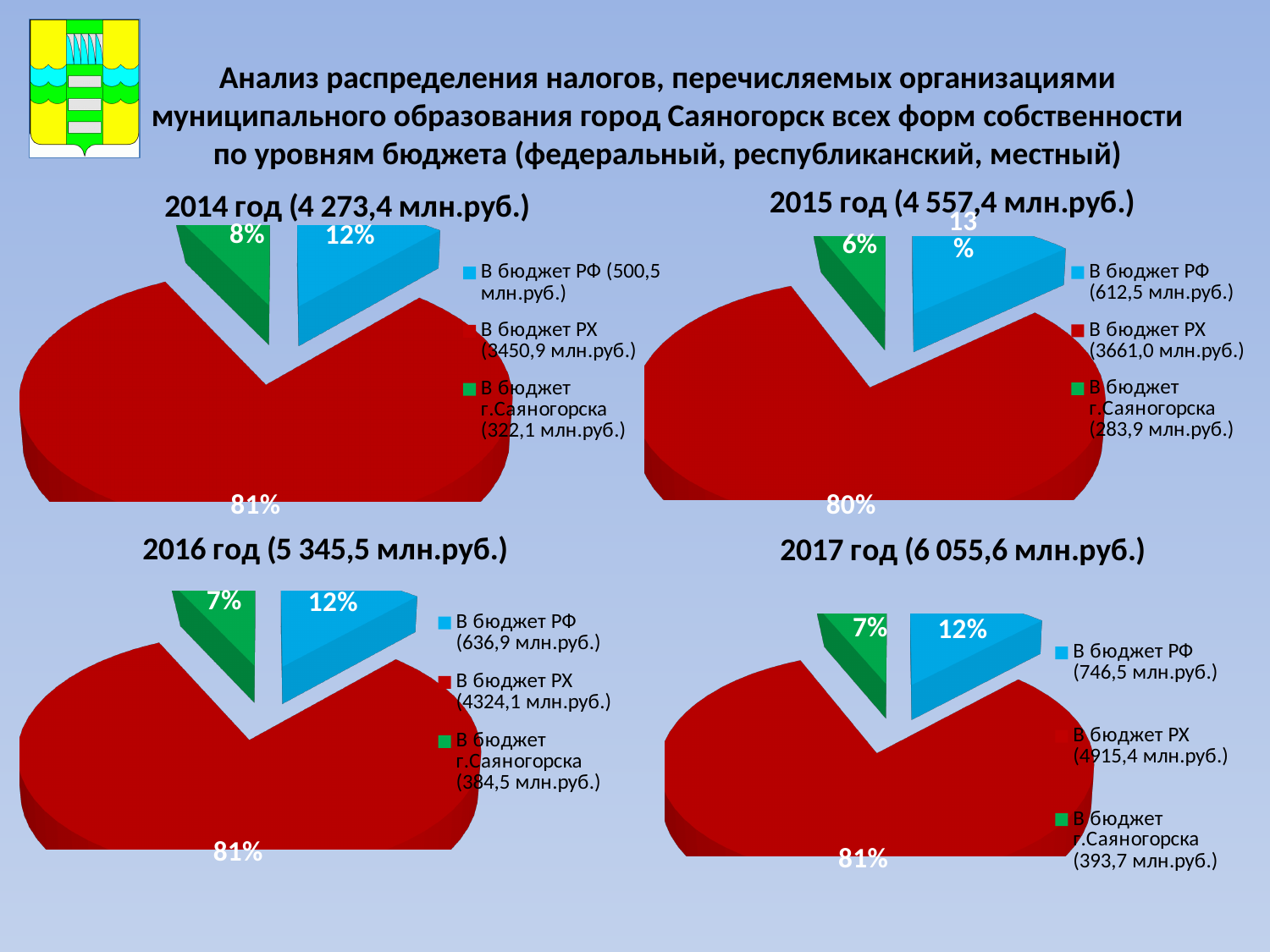
In the 2017 год chart, what share of the pie goes to В бюджет РФ? 12% What total is shown in the title of the 2016 год chart? 5 345,5 млн.руб. In the 2015 год chart, which category has the largest slice? В бюджет РХ What kind of chart is used for the 2014 год chart? Pie chart In the 2014 год chart, what share of the pie goes to В бюджет РХ? 81% In the 2015 год chart, what share of the pie goes to В бюджет г.Саяногорска? 6% In the 2014 год chart, what is the difference in percentage points between the В бюджет РФ slice and the В бюджет г.Саяногорска slice? 4 percentage points How many slices does the 2017 год pie chart have? 3 In the 2016 год chart, what value does the legend give for В бюджет РХ? 4324,1 млн.руб. In the 2016 год chart, which slice is larger: В бюджет РФ or В бюджет г.Саяногорска? В бюджет РФ In the 2017 год chart, what value does the legend give for В бюджет г.Саяногорска? 393,7 млн.руб. In the 2014 год chart, which category has the smallest slice? В бюджет г.Саяногорска